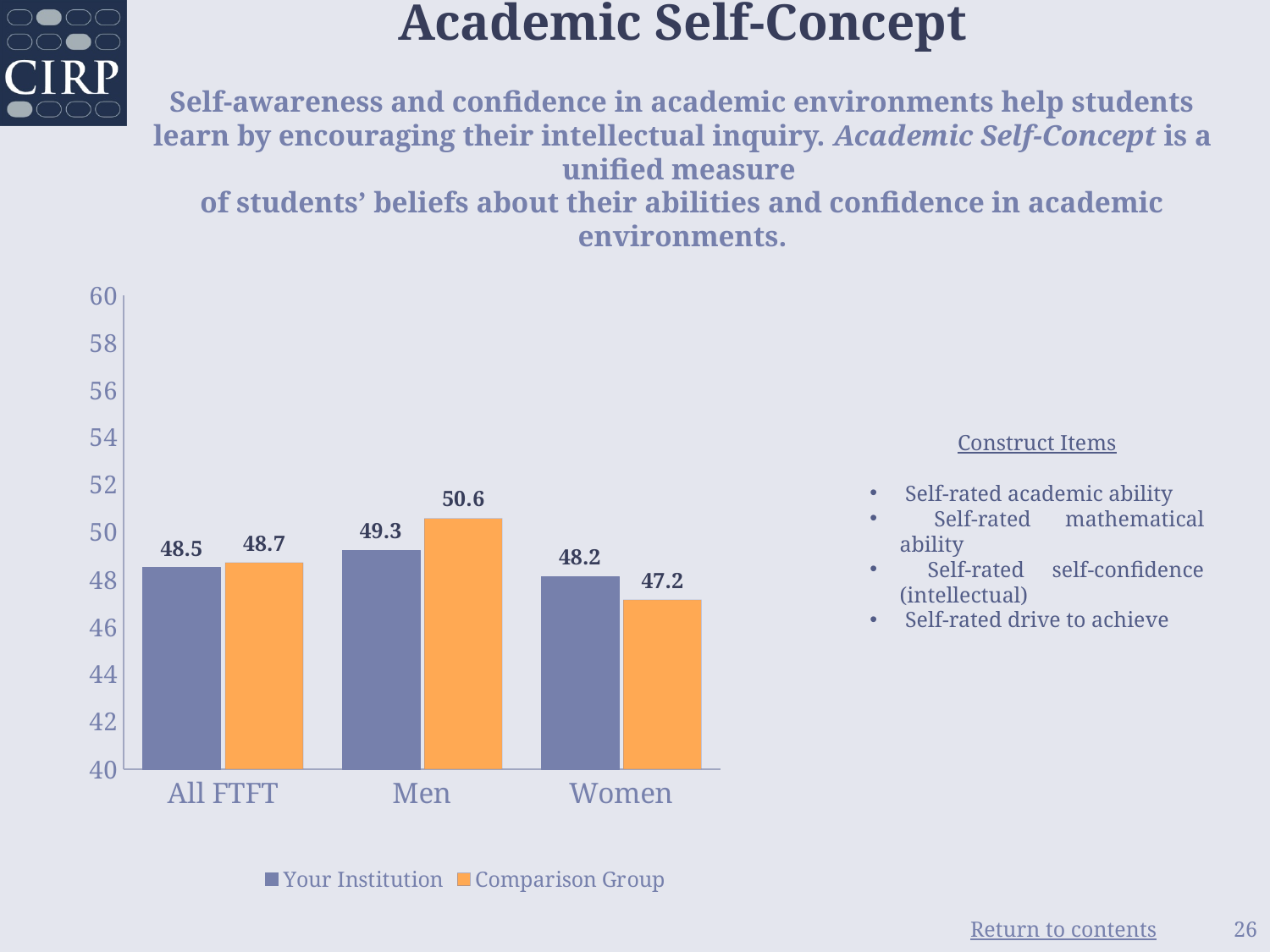
What is the value for the Comparison Group in the Women category? 47.2 How many series does the legend list? 2 Which category has the lowest Your Institution value? Women What colour are the Comparison Group bars? Orange What is the value for Your Institution in the All FTFT category? 48.5 What kind of chart is shown on the slide? Bar chart Is the Comparison Group value for Men greater or less than 50? greater For Women, which is larger: Your Institution or the Comparison Group? Your Institution What is the value for Your Institution in the Men category? 49.3 Which category has the highest Comparison Group value? Men What is the difference between the Comparison Group and Your Institution values for Men? 1.3 How many categories are shown on the x axis? 3